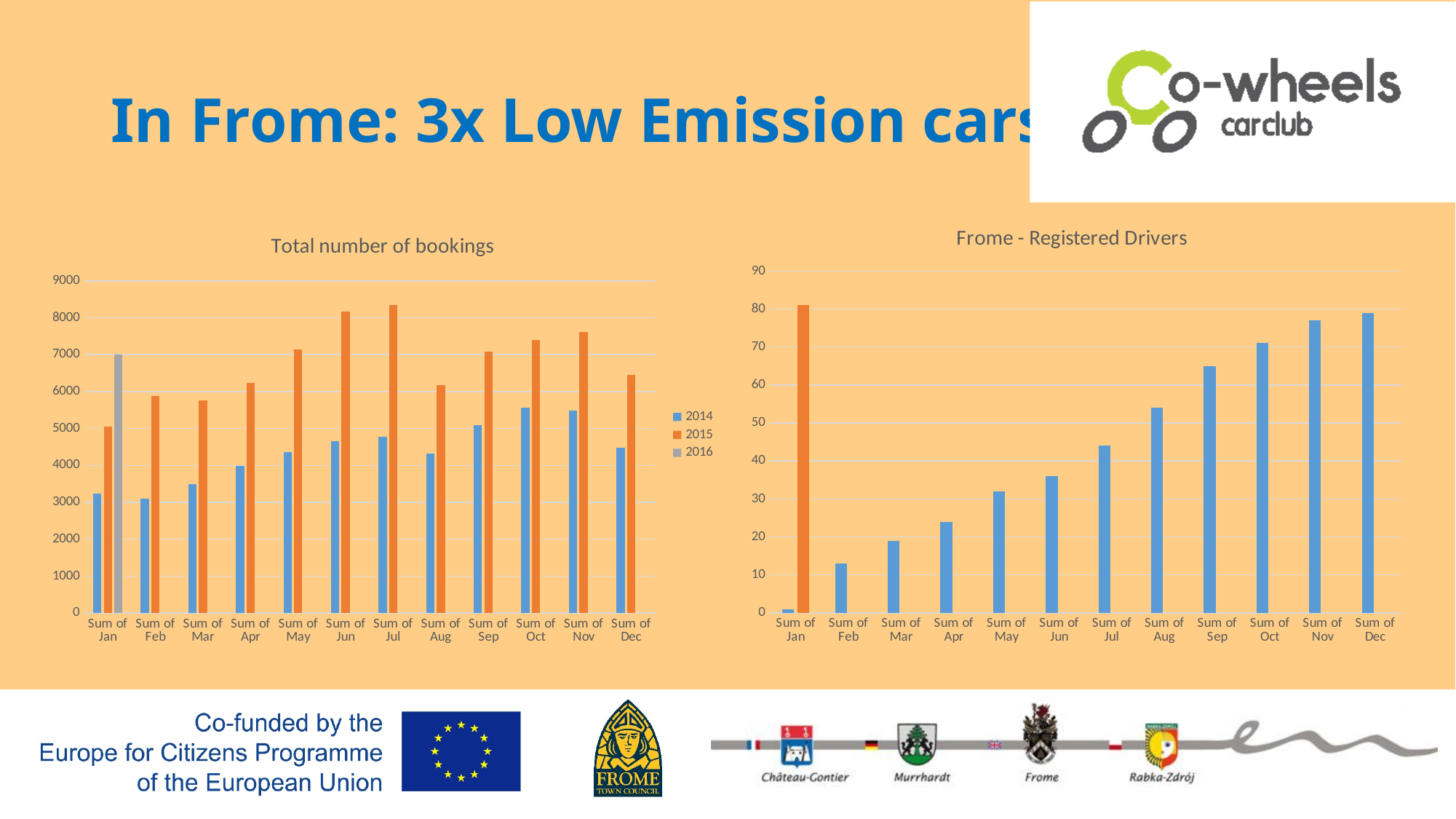
In the 'Frome - Registered Drivers' chart, is the value for Sum of Dec greater or less than 70? greater In the 'Frome - Registered Drivers' chart, which month has the tallest bar? Sum of Jan In the 'Total number of bookings' chart, which is larger for Sum of Jan: the 2014 value or the 2015 value? 2015 In the 'Total number of bookings' chart, is the 2016 value for Sum of Jan greater or less than 6000? greater In the 'Frome - Registered Drivers' chart, do the blue bars rise or fall from Sum of Feb to Sum of Dec? rise In the 'Total number of bookings' chart, is the 2014 value for Sum of Dec greater or less than 5000? less In the 'Total number of bookings' chart, which series is shown in orange? 2015 How many series does the legend of the 'Total number of bookings' chart list? 3 What kind of chart is the 'Total number of bookings' chart? bar chart How many months are shown on the x axis of the 'Frome - Registered Drivers' chart? 12